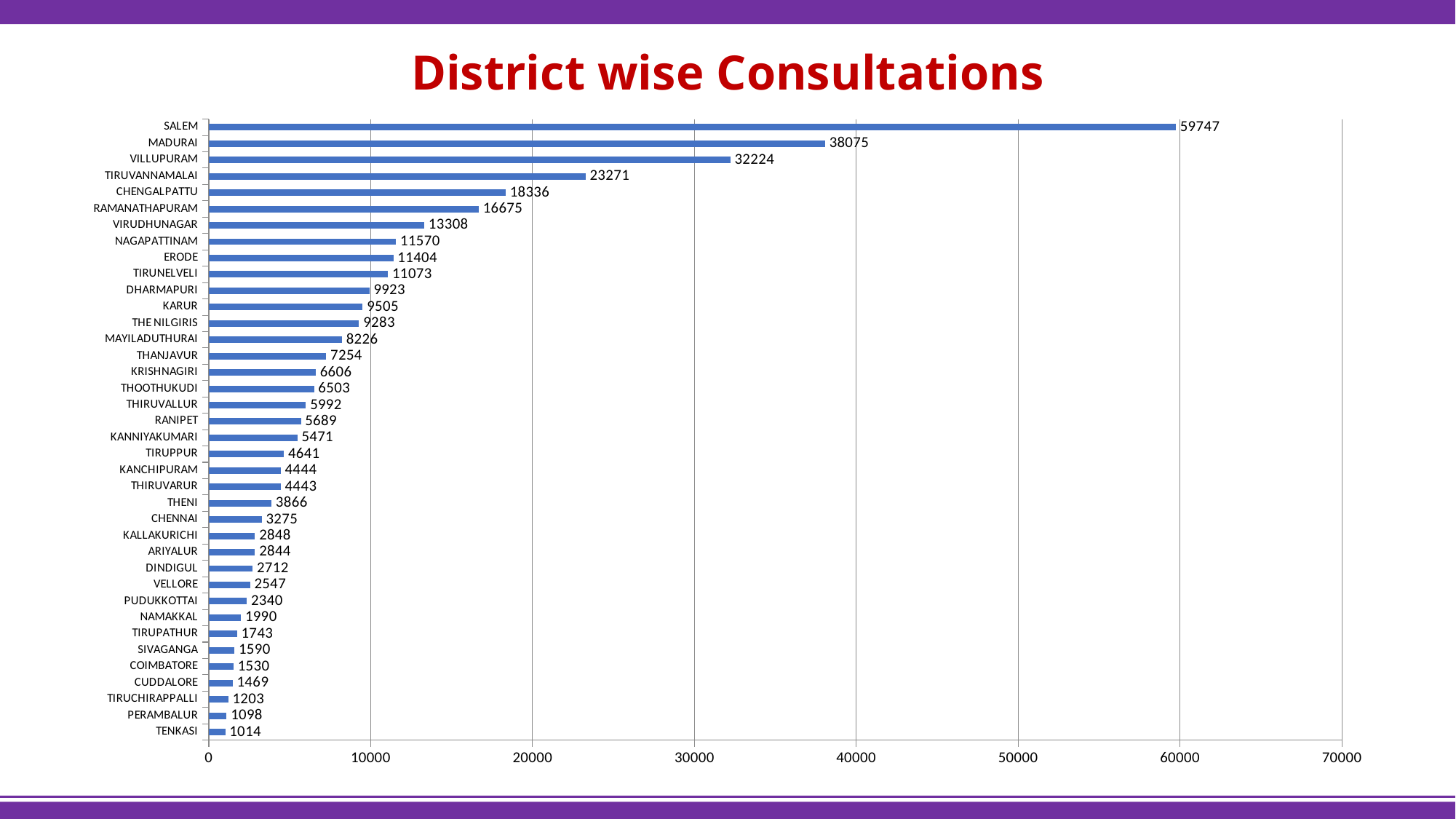
What kind of chart is shown on the slide? bar chart Which district has the lowest number of consultations? TENKASI Which district has the highest number of consultations? SALEM What is the difference between the values for SALEM and MADURAI? 21672 How many districts are shown in the chart? 38 What is the difference between the values for CHENNAI and COIMBATORE? 1745 What is the title of the chart? District wise Consultations Which has a larger value, VILLUPURAM or TIRUVANNAMALAI? VILLUPURAM Is the value for MADURAI greater or less than 40000? less What is the value for SALEM? 59747 What is the value for COIMBATORE? 1530 What is the value for CHENNAI? 3275